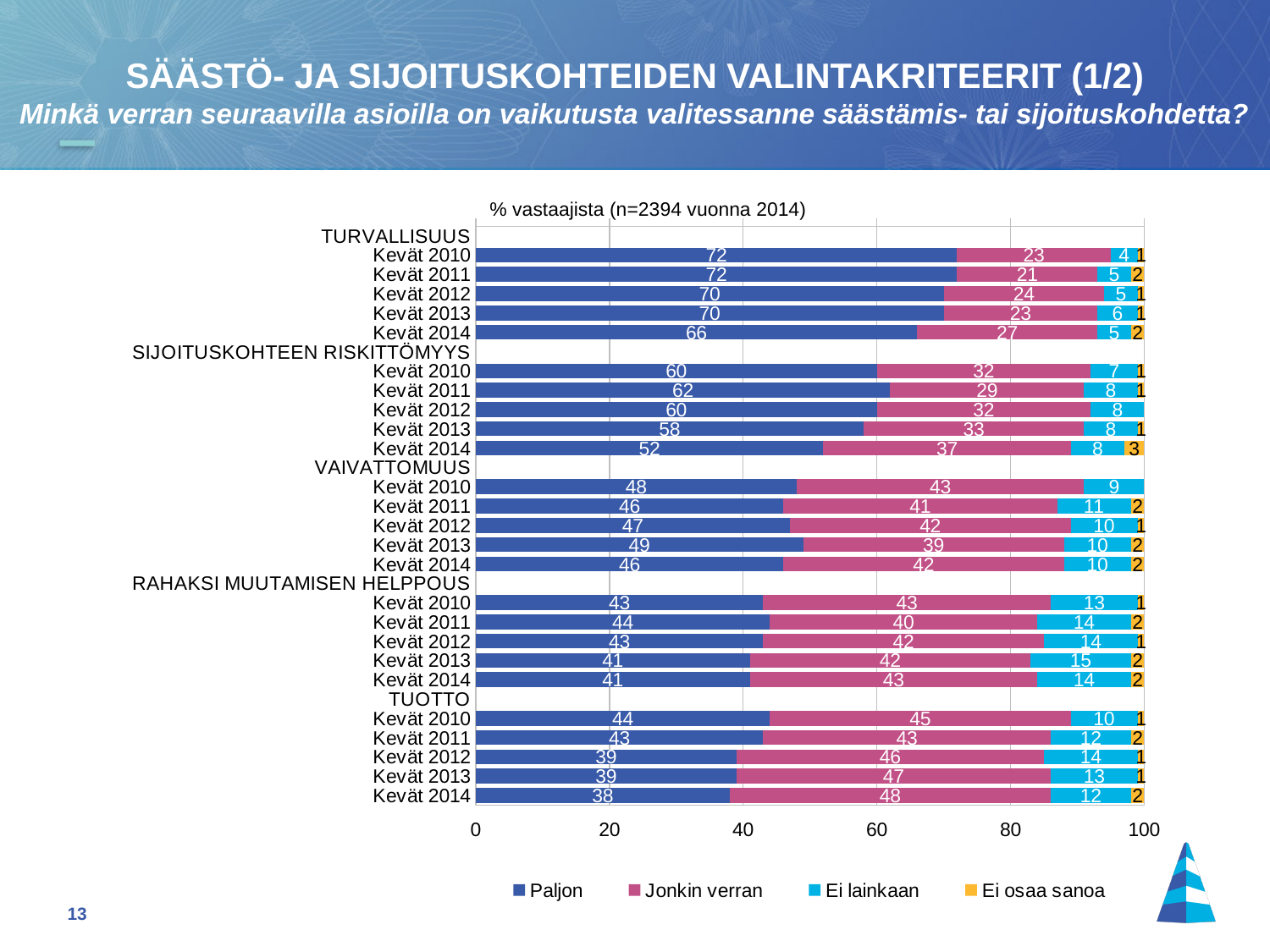
Which year has the highest "Paljon" value for Sijoituskohteen riskittömyys? Kevät 2011 Which year has the lowest "Paljon" value for Tuotto? Kevät 2014 What is the "Ei lainkaan" value for Rahaksi muutamisen helppous in Kevät 2013? 15 What is the "Jonkin verran" value for Tuotto in Kevät 2014? 48 For Vaivattomuus in Kevät 2013, which is larger: the "Paljon" value or the "Jonkin verran" value? Paljon How many series does the legend list? 4 What is the total of the "Paljon" and "Jonkin verran" values for Tuotto in Kevät 2012? 85 What is the sample size (n) stated for 2014 above the chart? n=2394 What is the "Paljon" value for Turvallisuus in Kevät 2014? 66 What is the difference between the "Paljon" values for Turvallisuus in Kevät 2010 and Kevät 2014? 6 How does the "Paljon" value for Sijoituskohteen riskittömyys change from Kevät 2012 to Kevät 2014? It falls What kind of chart is shown on the slide? Stacked bar chart